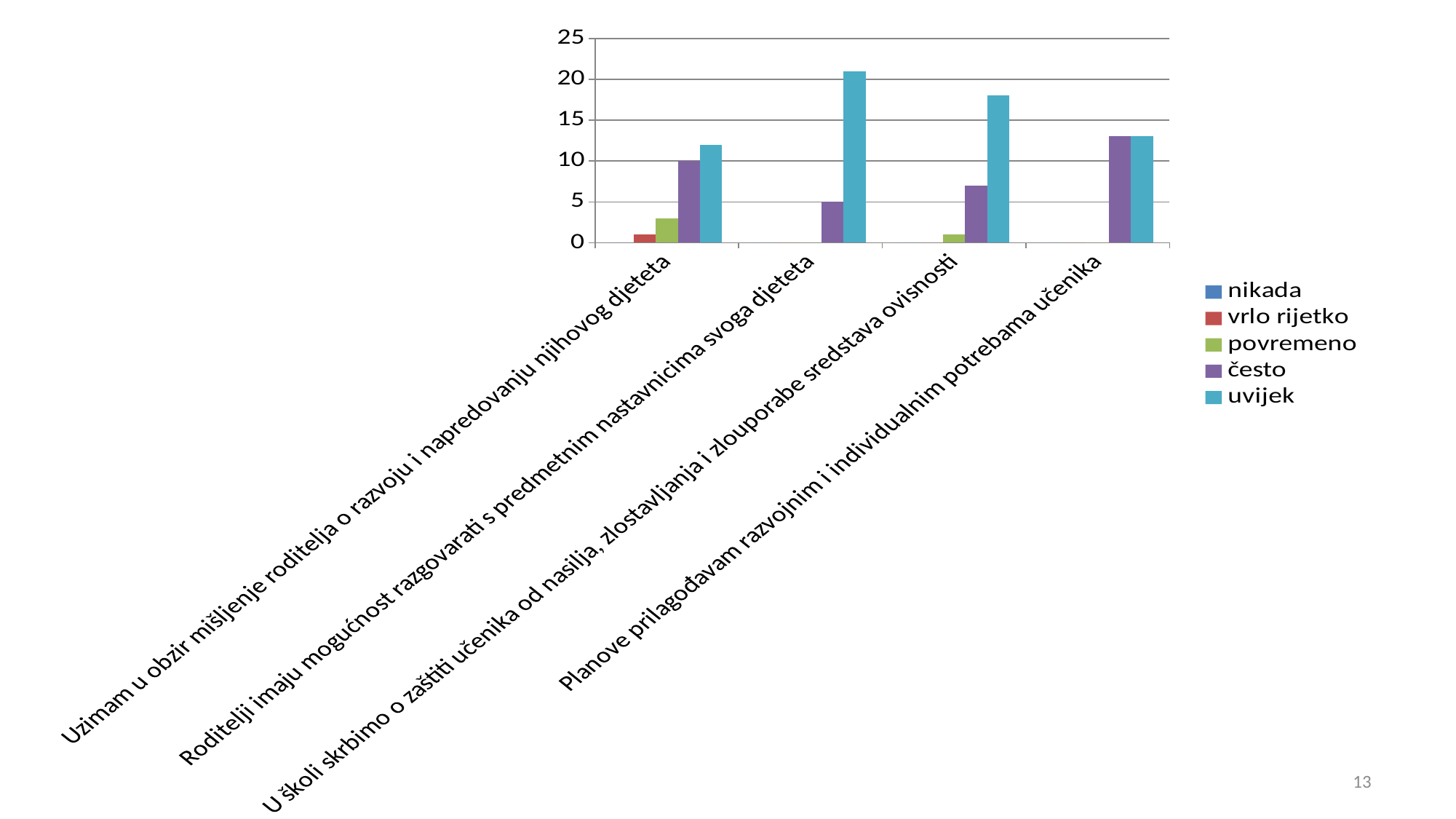
Is the value of 'povremeno' for 'Uzimam u obzir mišljenje roditelja o razvoju i napredovanju njihovog djeteta' greater or less than 5? less What is the value of 'često' for the category 'Roditelji imaju mogućnost razgovarati s predmetnim nastavnicima svoga djeteta'? 5 What is the value of 'često' for the category 'Uzimam u obzir mišljenje roditelja o razvoju i napredovanju njihovog djeteta'? 10 What type of chart is shown on the slide? bar chart For 'U školi skrbimo o zaštiti učenika od nasilja, zlostavljanja i zlouporabe sredstava ovisnosti', which is larger: 'često' or 'uvijek'? uvijek Which category has the highest 'uvijek' value? Roditelji imaju mogućnost razgovarati s predmetnim nastavnicima svoga djeteta How many series does the legend list? 5 Which category has the lowest 'uvijek' value? Uzimam u obzir mišljenje roditelja o razvoju i napredovanju njihovog djeteta Is the value of 'uvijek' for 'U školi skrbimo o zaštiti učenika od nasilja, zlostavljanja i zlouporabe sredstava ovisnosti' greater or less than 15? greater Which series is shown in purple in the legend? često Is the value of 'uvijek' for 'Roditelji imaju mogućnost razgovarati s predmetnim nastavnicima svoga djeteta' greater or less than 20? greater How many categories are shown on the x axis? 4